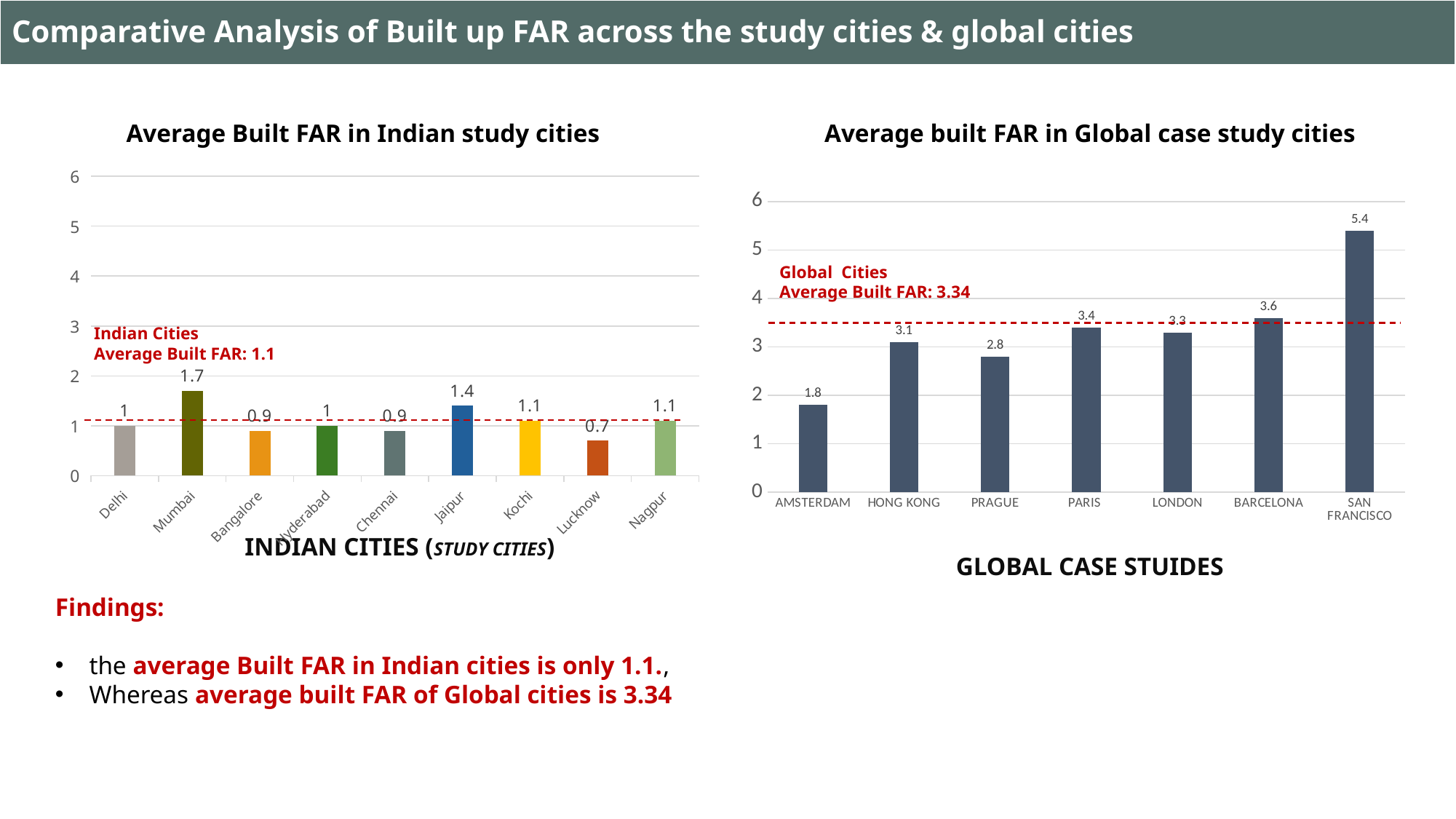
In the 'Average built FAR in Global case study cities' chart, what is the difference between San Francisco and Barcelona? 1.8 In the 'Average built FAR in Global case study cities' chart, what is the value for San Francisco? 5.4 What kind of chart is the 'Average built FAR in Global case study cities' chart? Bar chart In the 'Average Built FAR in Indian study cities' chart, what is the value for Mumbai? 1.7 In the 'Average built FAR in Global case study cities' chart, which city has the lowest value? Amsterdam In the 'Average Built FAR in Indian study cities' chart, which city has the highest value? Mumbai In the 'Average Built FAR in Indian study cities' chart, which city has the lowest value? Lucknow In the 'Average Built FAR in Indian study cities' chart, how many cities are shown? 9 In the 'Average built FAR in Global case study cities' chart, which is larger, Paris or London? Paris In the 'Average built FAR in Global case study cities' chart, how many cities are shown? 7 In the 'Average Built FAR in Indian study cities' chart, what is the difference between Jaipur and Chennai? 0.5 In the 'Average built FAR in Global case study cities' chart, what average value does the red dashed line represent? 3.34